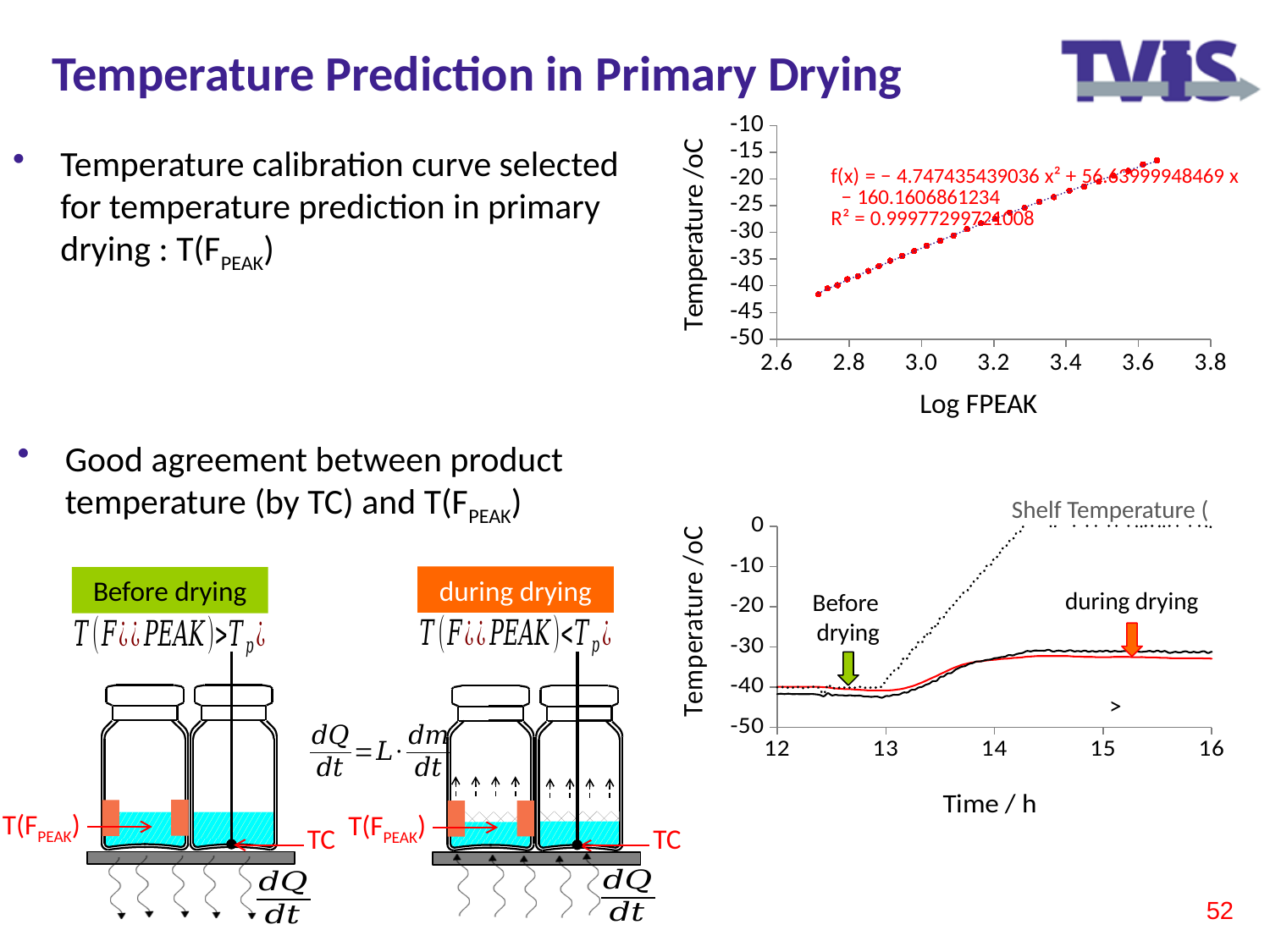
In the top-right chart, what is the lowest value shown on the y axis? -50 In the top-right chart, do the plotted temperature values rise or fall as Log FPEAK increases? rise In the top-right chart, is the temperature at Log FPEAK 3.6 greater or less than -25? greater In the top-right chart, is the temperature at Log FPEAK 2.8 greater or less than -35? less In the bottom-right chart, does the product temperature rise or fall between 13 h and 14 h? rise In the bottom-right chart, what is the label of the x axis? Time / h What kind of chart is the bottom-right chart plotting Temperature against Time / h? line chart In the bottom-right chart, is the product temperature at 12 h greater or less than -30? less In the top-right chart, what R² value is printed for the fitted curve? 0.999772997241008 What kind of chart is the top-right chart plotting Temperature against Log FPEAK? scatter chart In the top-right chart, what is the label of the x axis? Log FPEAK